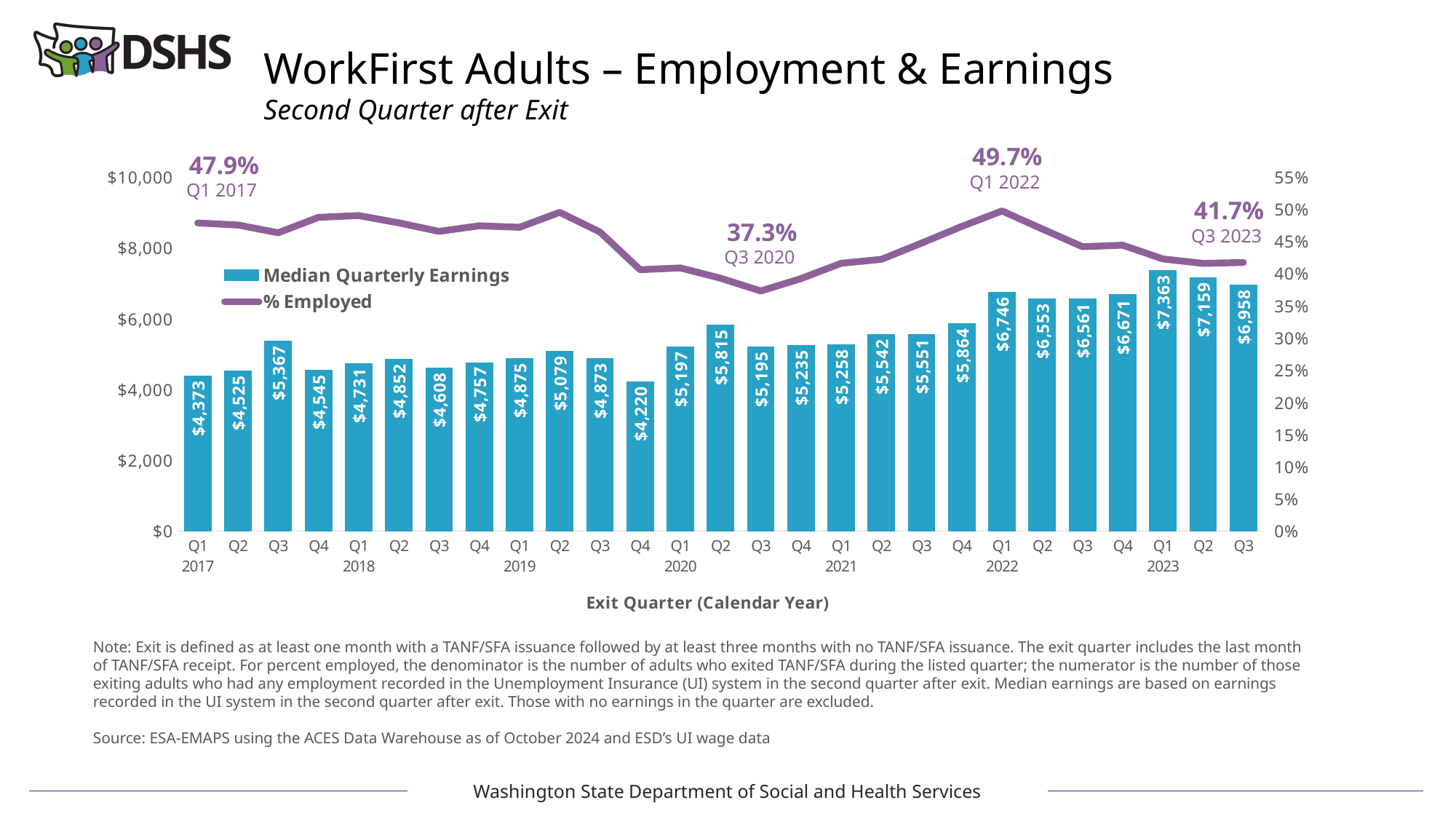
How many series does the legend list? 2 Which exit quarter has the lowest median quarterly earnings? Q4 2019 What is the difference in median quarterly earnings between Q1 2023 and Q4 2019? $3,143 Which has higher median quarterly earnings, Q2 2020 or Q3 2020? Q2 2020 How many exit quarters are shown on the x axis? 27 Is the % Employed value for Q4 2019 greater or less than 45%? less What is the median quarterly earnings value for Q4 2019? $4,220 What percent employed is labeled for Q1 2022? 49.7% Which exit quarter has the highest median quarterly earnings? Q1 2023 What is the median quarterly earnings value for Q1 2023? $7,363 What percent employed is labeled for Q3 2020? 37.3% What is the difference in median quarterly earnings between Q1 2022 and Q4 2021? $882